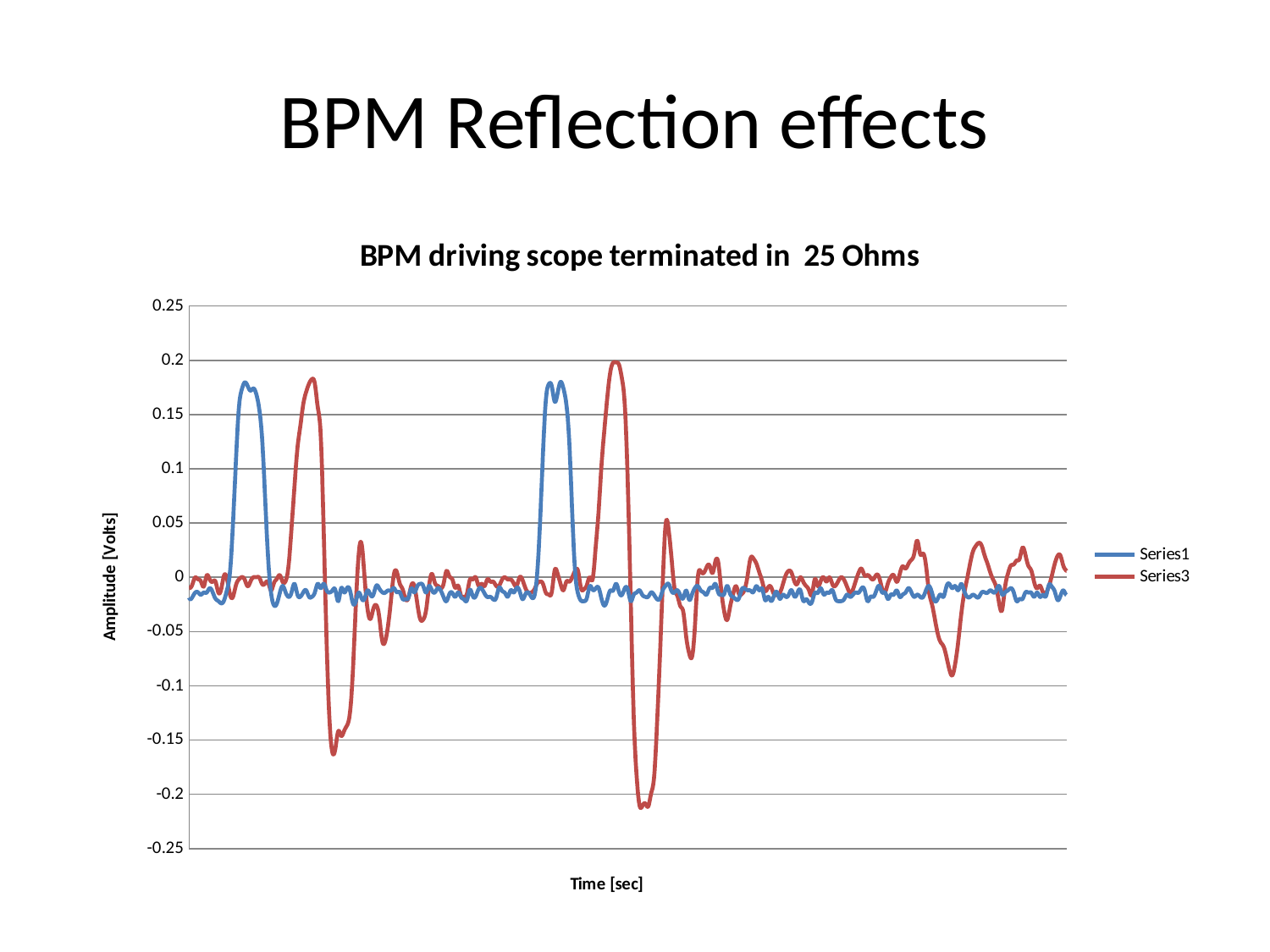
What is the title of the chart? BPM driving scope terminated in 25 Ohms Is the lowest value reached by Series3 greater or less than -0.15? less Which series reaches the lowest value on the chart, Series1 or Series3? Series3 What kind of chart is shown on the slide? line chart Is the highest value reached by Series1 greater or less than 0.2? less How many series does the legend list? 2 Is the highest value reached by Series3 greater or less than 0.15? greater What is the label of the vertical axis? Amplitude [Volts]